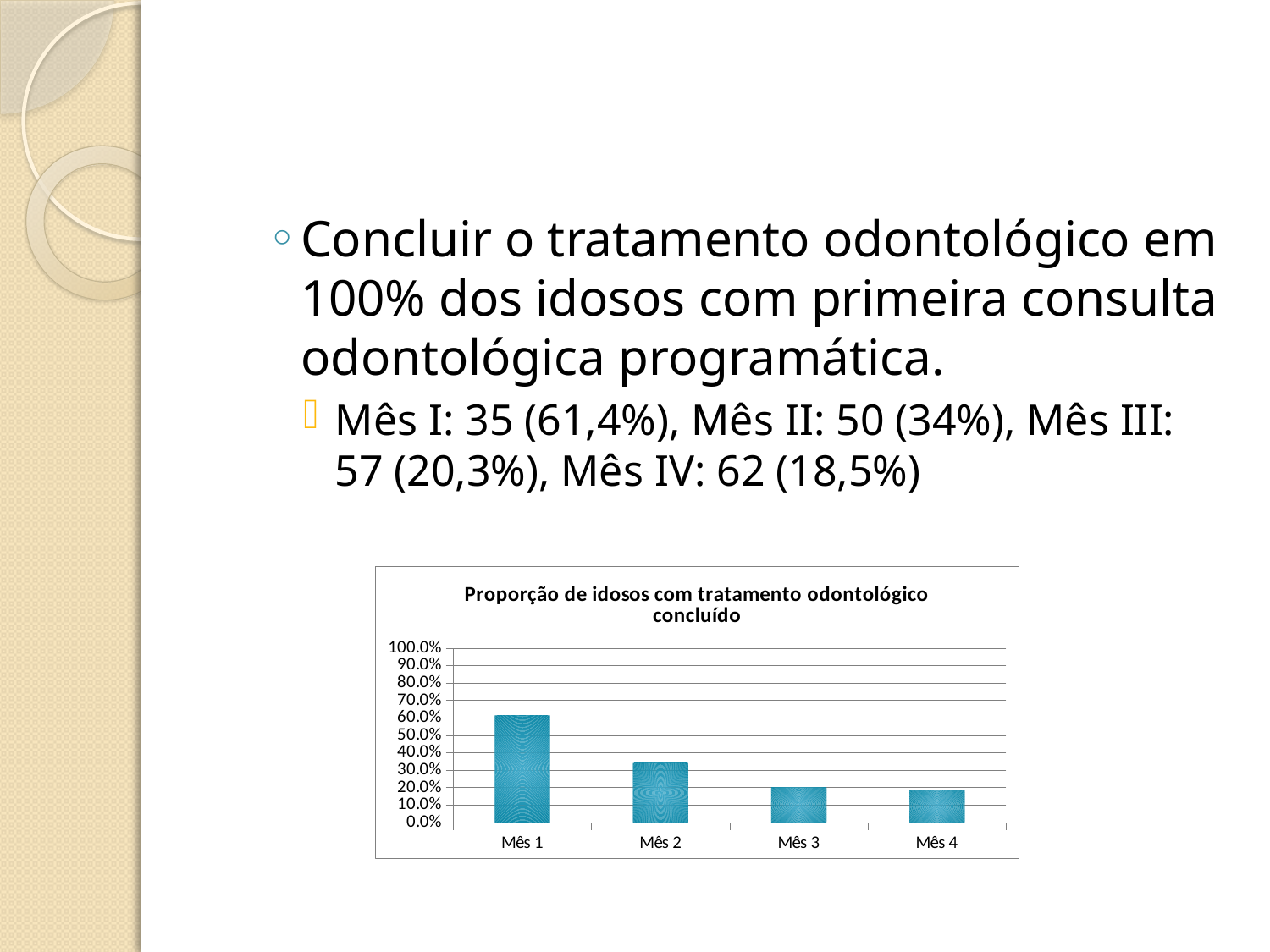
What is the title of the chart? Proporção de idosos com tratamento odontológico concluído Which is larger, the value for Mês 2 or the value for Mês 4? Mês 2 What type of chart is shown on the slide? bar chart Do the values rise or fall from Mês 1 to Mês 4? fall Which month has the highest proportion in the chart? Mês 1 Is the value for Mês 4 greater or less than 30%? less Is the value for Mês 2 greater or less than 30%? greater Is the value for Mês 2 greater or less than 40%? less How many categories are shown on the x axis of the chart? 4 Which is larger, the value for Mês 1 or the value for Mês 2? Mês 1